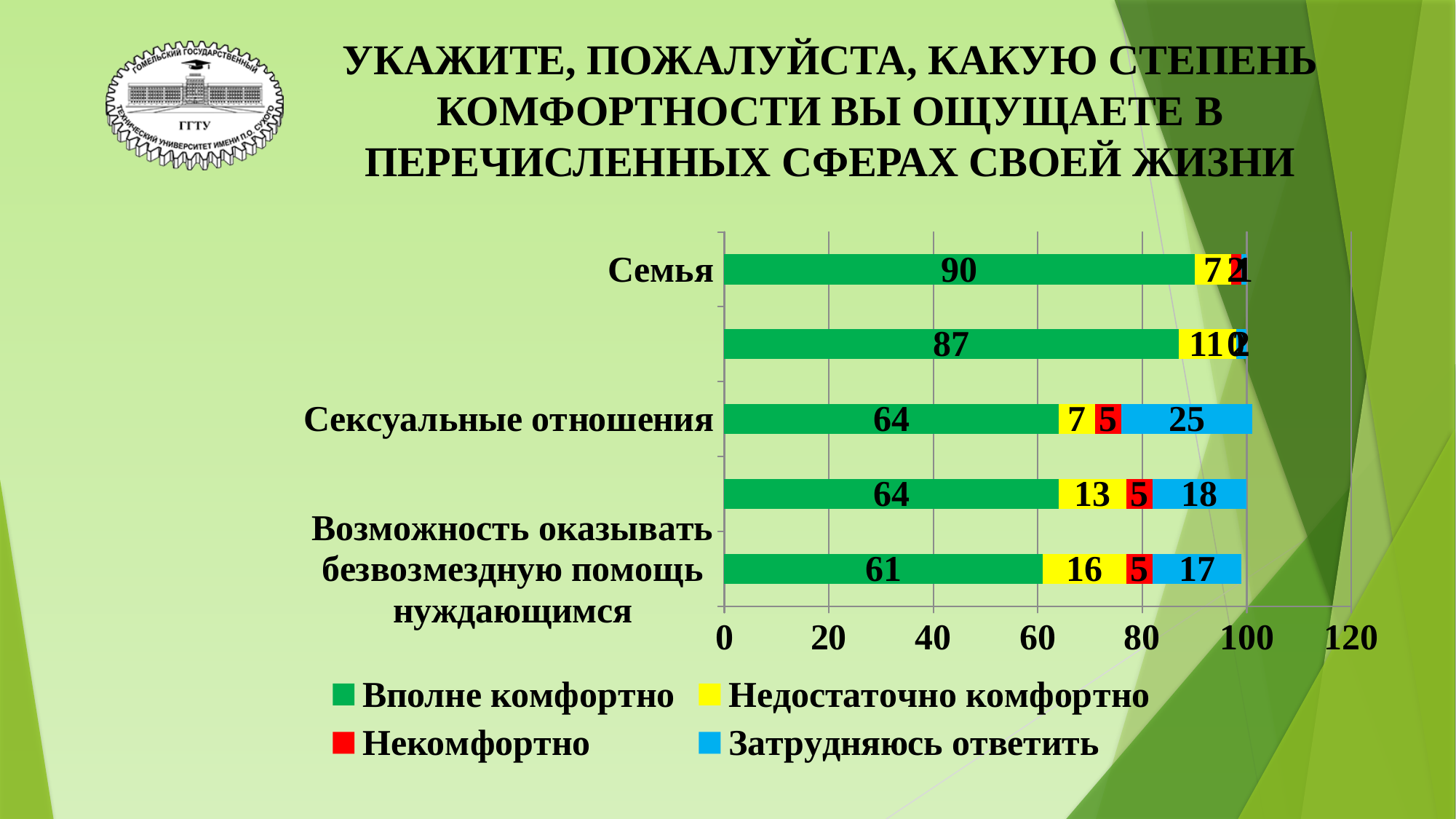
Is the "Вполне комфортно" value for "Семья" greater or less than 80? greater Which category has the highest value for "Вполне комфортно"? Семья Which is larger: the "Затрудняюсь ответить" value for "Сексуальные отношения" or for "Возможность оказывать безвозмездную помощь нуждающимся"? Сексуальные отношения How many bars are plotted in the chart? 5 What is the total of the stacked bar for "Возможность оказывать безвозмездную помощь нуждающимся"? 99 How many series does the legend list? 4 What is the difference between the "Вполне комфортно" values for "Семья" and "Сексуальные отношения"? 26 What is the value of "Некомфортно" for "Сексуальные отношения"? 5 What is the value of "Затрудняюсь ответить" for "Сексуальные отношения"? 25 What is the value of "Вполне комфортно" for "Семья"? 90 What kind of chart is shown on the slide? stacked bar chart What is the value of "Недостаточно комфортно" for "Возможность оказывать безвозмездную помощь нуждающимся"? 16